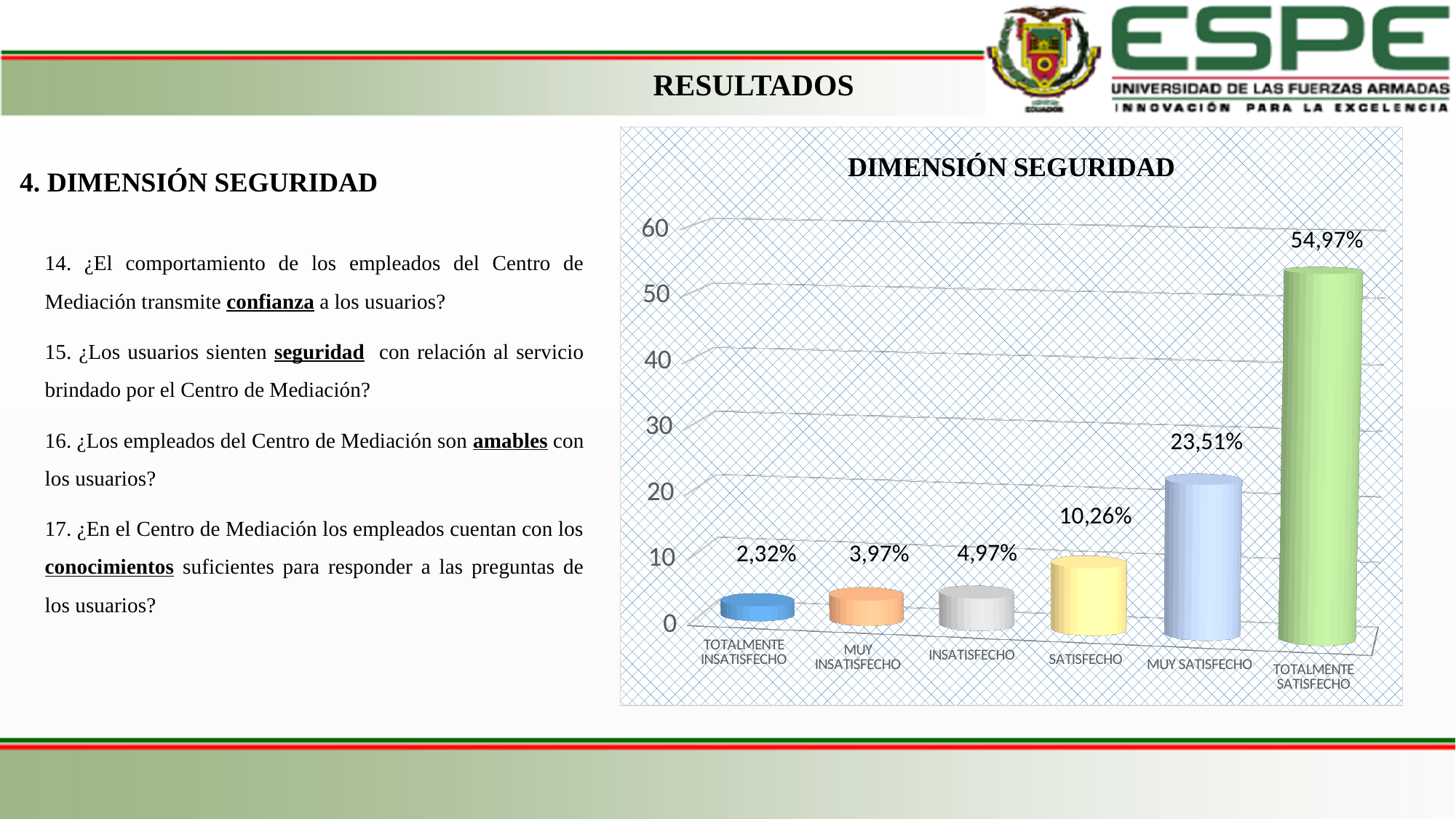
Which category has the lowest value? TOTALMENTE INSATISFECHO Which category has the highest value? TOTALMENTE SATISFECHO Do the values rise or fall from left to right along the x axis? Rise What is the difference between the values for INSATISFECHO and MUY INSATISFECHO? 1,00% What kind of chart is shown on the slide? Bar chart What is the value for MUY SATISFECHO? 23,51% What is the value for TOTALMENTE INSATISFECHO? 2,32% What is the value for SATISFECHO? 10,26% Which is larger, the value for SATISFECHO or the value for INSATISFECHO? SATISFECHO How many categories are shown on the x axis of the chart? 6 What is the value for TOTALMENTE SATISFECHO in the DIMENSIÓN SEGURIDAD chart? 54,97% What is the difference between the values for TOTALMENTE SATISFECHO and MUY SATISFECHO? 31,46%